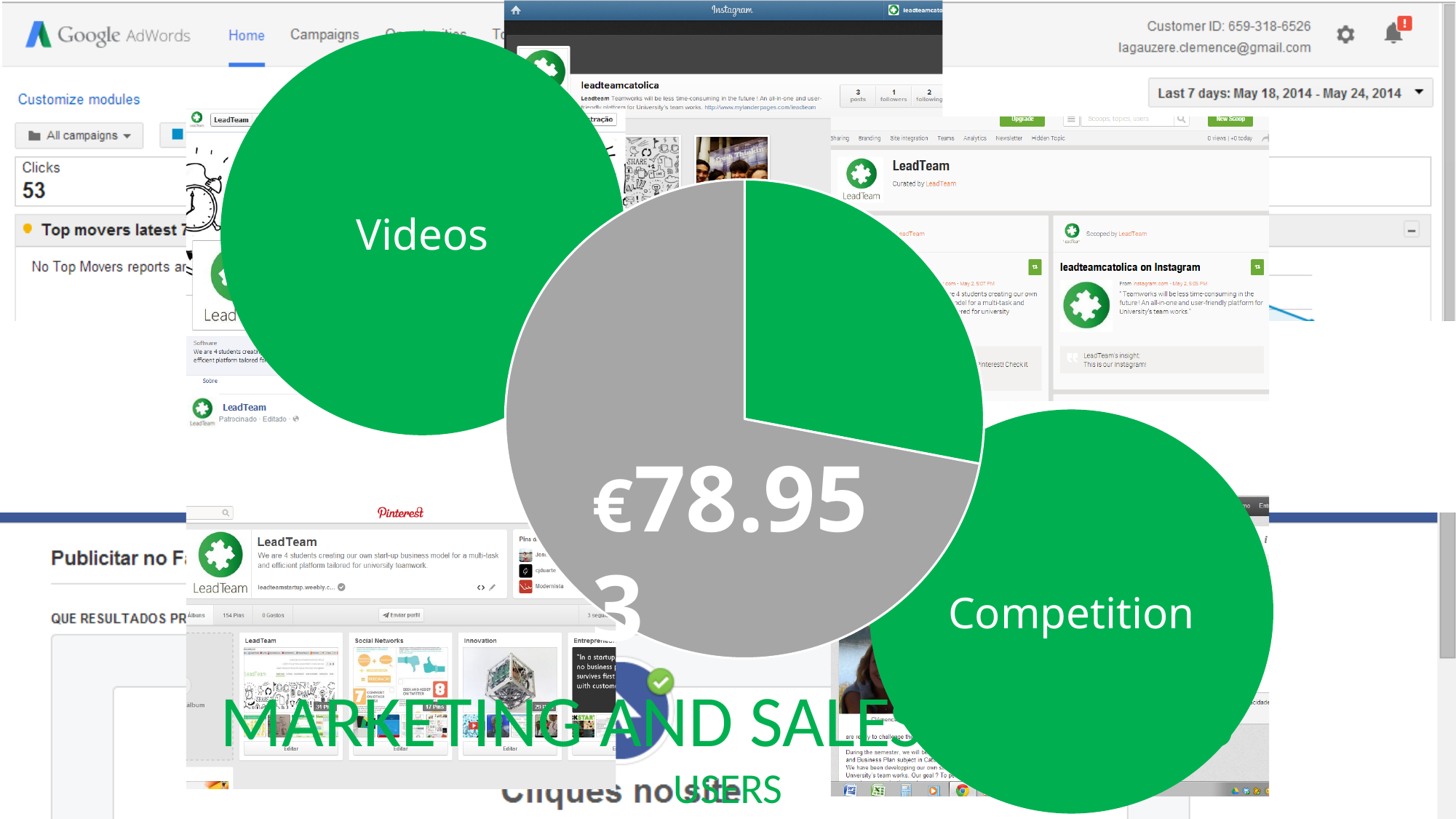
What kind of chart is shown in the centre of the slide? pie chart Which slice of the pie chart is larger, the grey one or the green one? grey Does the pie chart show a legend? no What two colours are used for the slices of the pie chart? green and grey Does the grey slice of the pie chart take up more or less than half of the pie? more How many slices does the pie chart have? 2 What value is printed on the grey slice of the pie chart? €78.953 Which slice of the pie chart is the smallest? the green slice